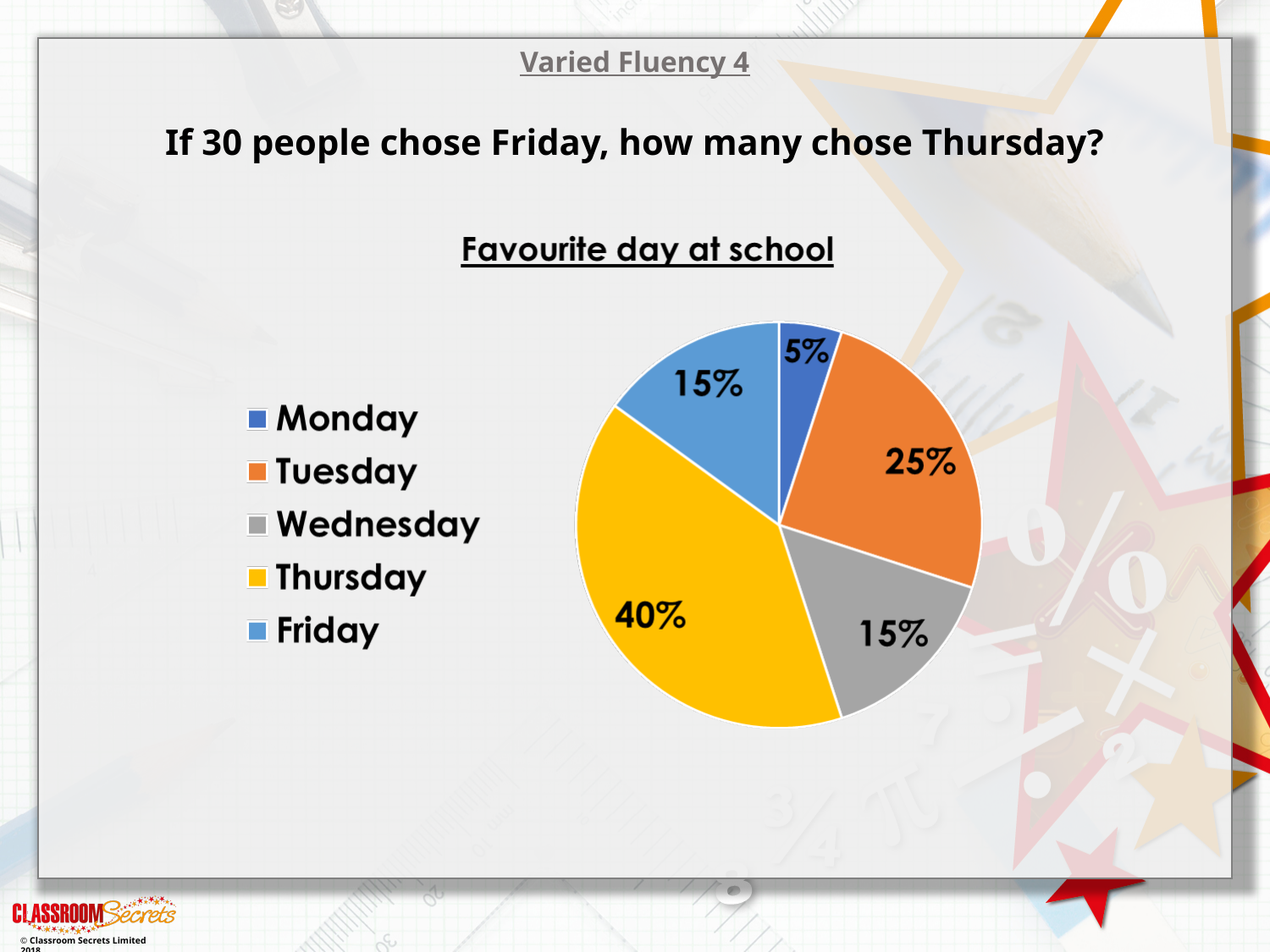
What percentage of people chose Thursday as their favourite day? 40% Which day has the largest share of the pie? Thursday How many days are shown in the legend? 5 Which colour represents Thursday in the chart? yellow What is the title of the chart? Favourite day at school What percentage of people chose Tuesday? 25% What type of chart is shown on the slide? pie chart Which has a larger share, Tuesday or Friday? Tuesday What percentage of people chose Monday? 5% What is the combined percentage for Wednesday and Friday? 30% Which day has the smallest share of the pie? Monday What is the difference in percentage points between Thursday and Tuesday? 15